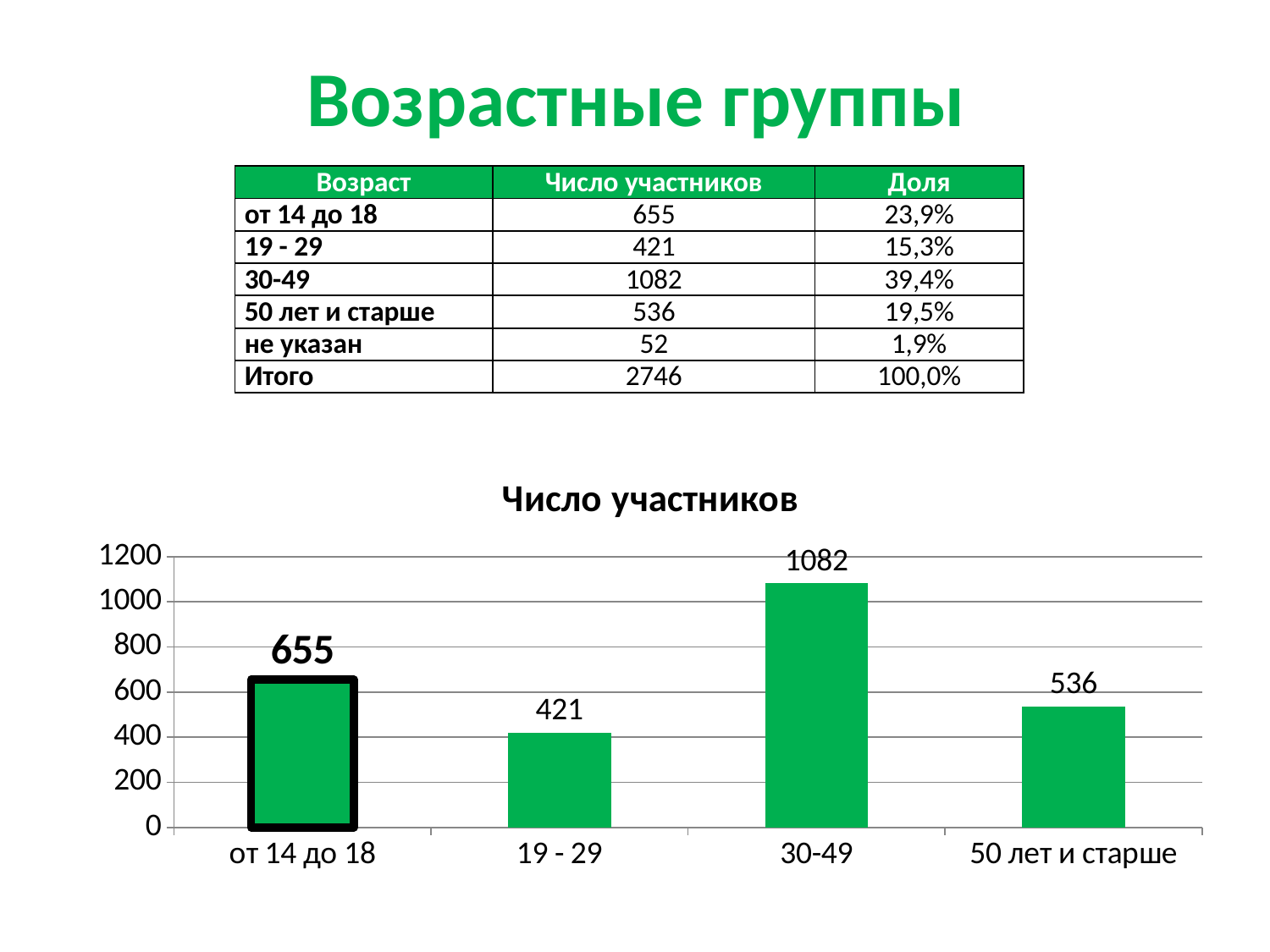
Which is larger: the value for 'от 14 до 18' or the value for '19 - 29'? от 14 до 18 What is the value for '50 лет и старше' in the chart? 536 What kind of chart is shown on the slide? bar chart What is the value for the '19 - 29' category in the chart? 421 Is the value for '50 лет и старше' greater or less than 600? less How many categories are shown on the x axis of the chart? 4 What is the difference between the values for 'от 14 до 18' and '50 лет и старше'? 119 Which category has the lowest value in the chart? 19 - 29 What is the difference between the values for '30-49' and 'от 14 до 18'? 427 Which category has the highest value in the chart? 30-49 What is the title of the chart? Число участников What is the value for the '30-49' category in the chart? 1082